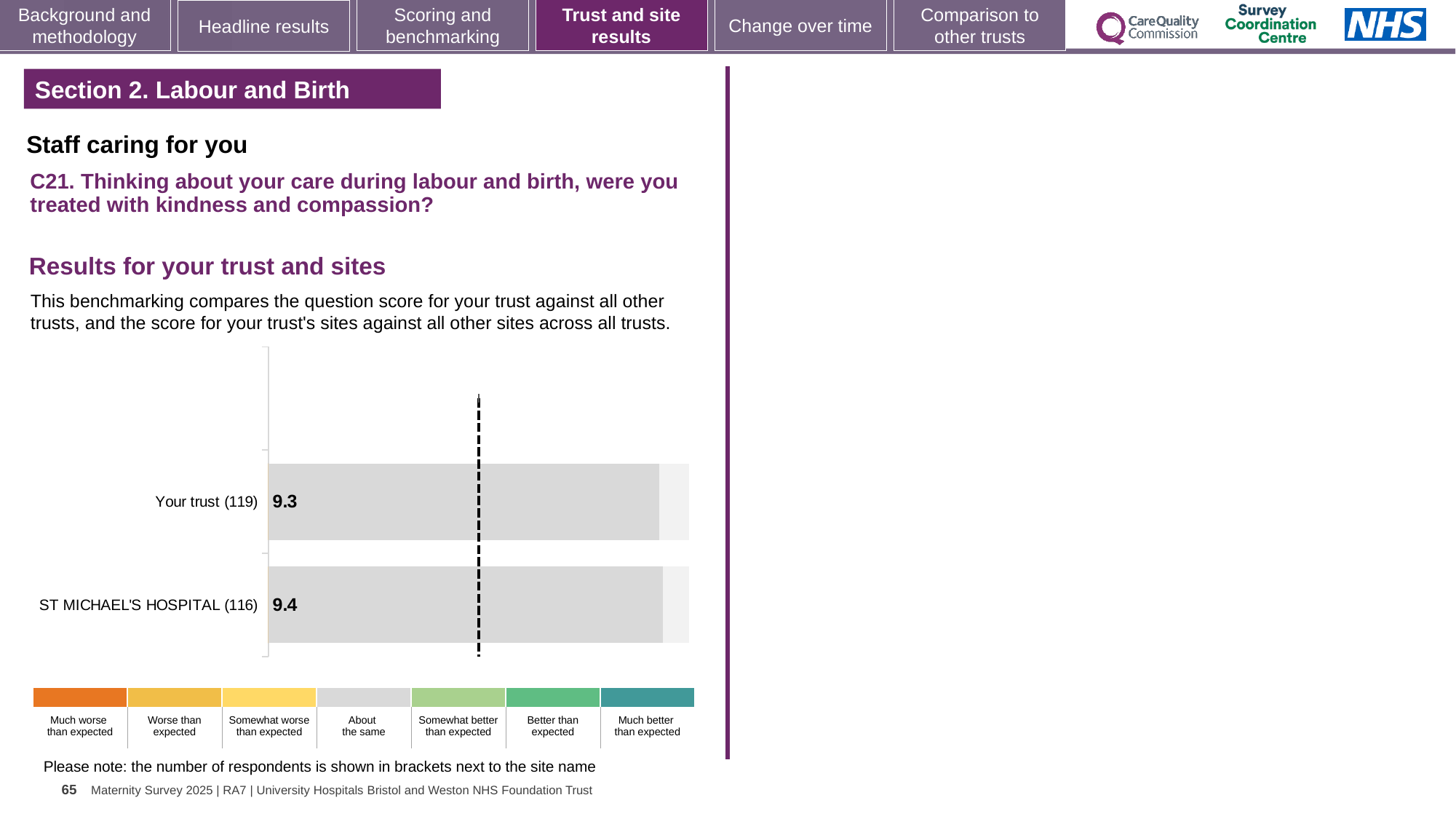
What is the score for Your trust (119)? 9.3 Which has the higher score, Your trust or ST MICHAEL'S HOSPITAL? ST MICHAEL'S HOSPITAL What is the difference between the score for ST MICHAEL'S HOSPITAL and the score for Your trust? 0.1 How many respondents are shown in brackets for ST MICHAEL'S HOSPITAL? 116 How many benchmark categories does the colour key below the chart list? 7 What kind of chart is shown on the slide? Bar chart What is the score for ST MICHAEL'S HOSPITAL (116)? 9.4 Which bar shows the highest score? ST MICHAEL'S HOSPITAL (116) Which bar shows the lowest score? Your trust (119) How many respondents are shown in brackets for Your trust? 119 Which benchmark category in the colour key does the grey colour of the bars correspond to? About the same How many bars are plotted in the chart? 2